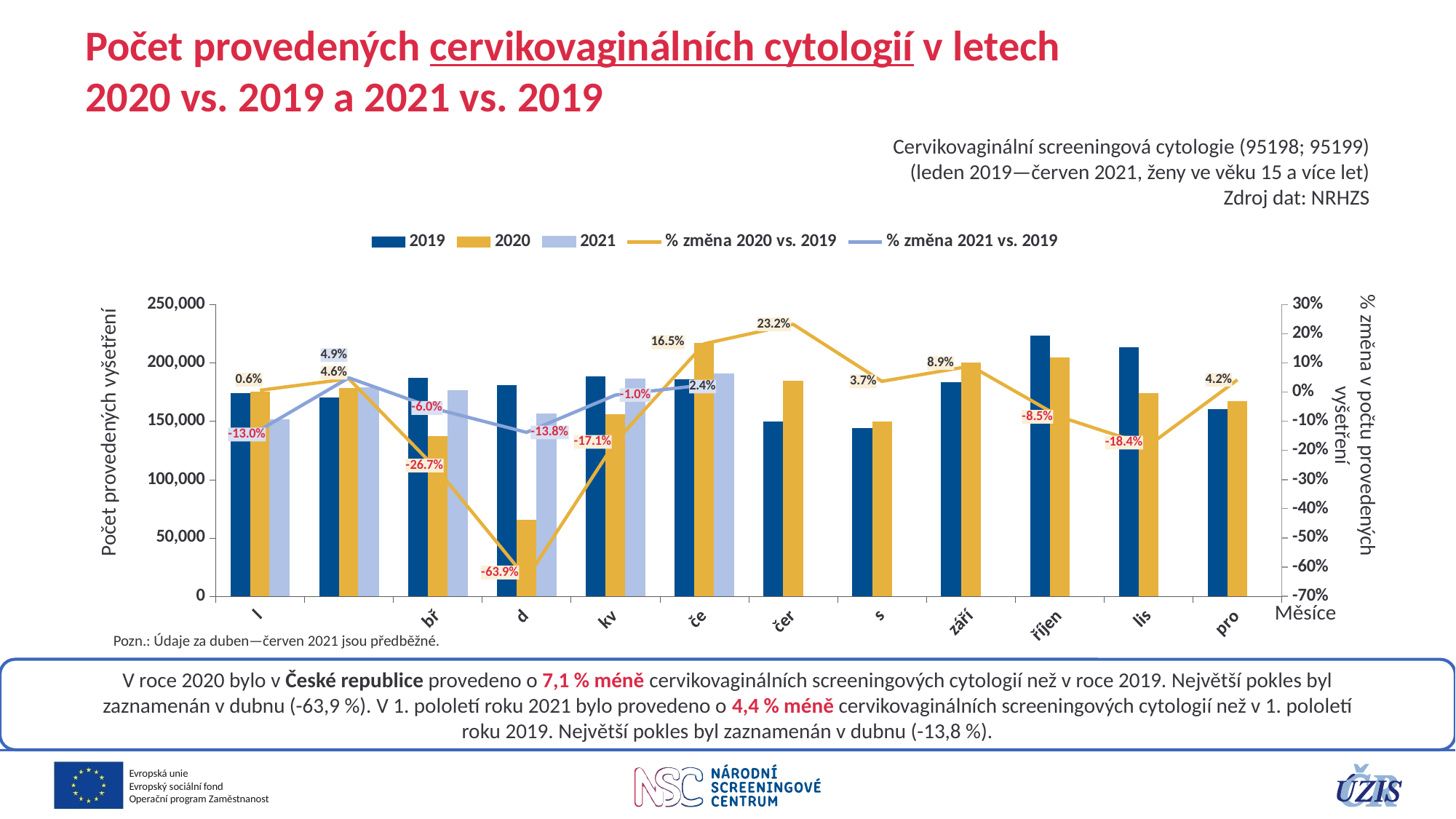
What is the value of the '% změna 2020 vs. 2019' line for the month 'd'? -63.9% What is the value of the '% změna 2021 vs. 2019' line for the month 'če'? 2.4% In which month does the '% změna 2020 vs. 2019' line reach its lowest value? d For the month 'čer', which bar is taller: 2019 or 2020? 2020 Is the 2019 bar for 'říjen' greater or less than 200,000? greater What is the highest value shown on the '% změna 2021 vs. 2019' line? 4.9% What is the difference in percentage points between the '% změna 2020 vs. 2019' values for 'čer' and 'če'? 6.7 percentage points What is the value of the '% změna 2021 vs. 2019' line for the month 'l'? -13.0% How many months have a 2021 bar plotted? 6 In which month does the '% změna 2020 vs. 2019' line reach its highest value? čer Is the 2020 bar for 'd' greater or less than 100,000? less How many series does the legend list? 5